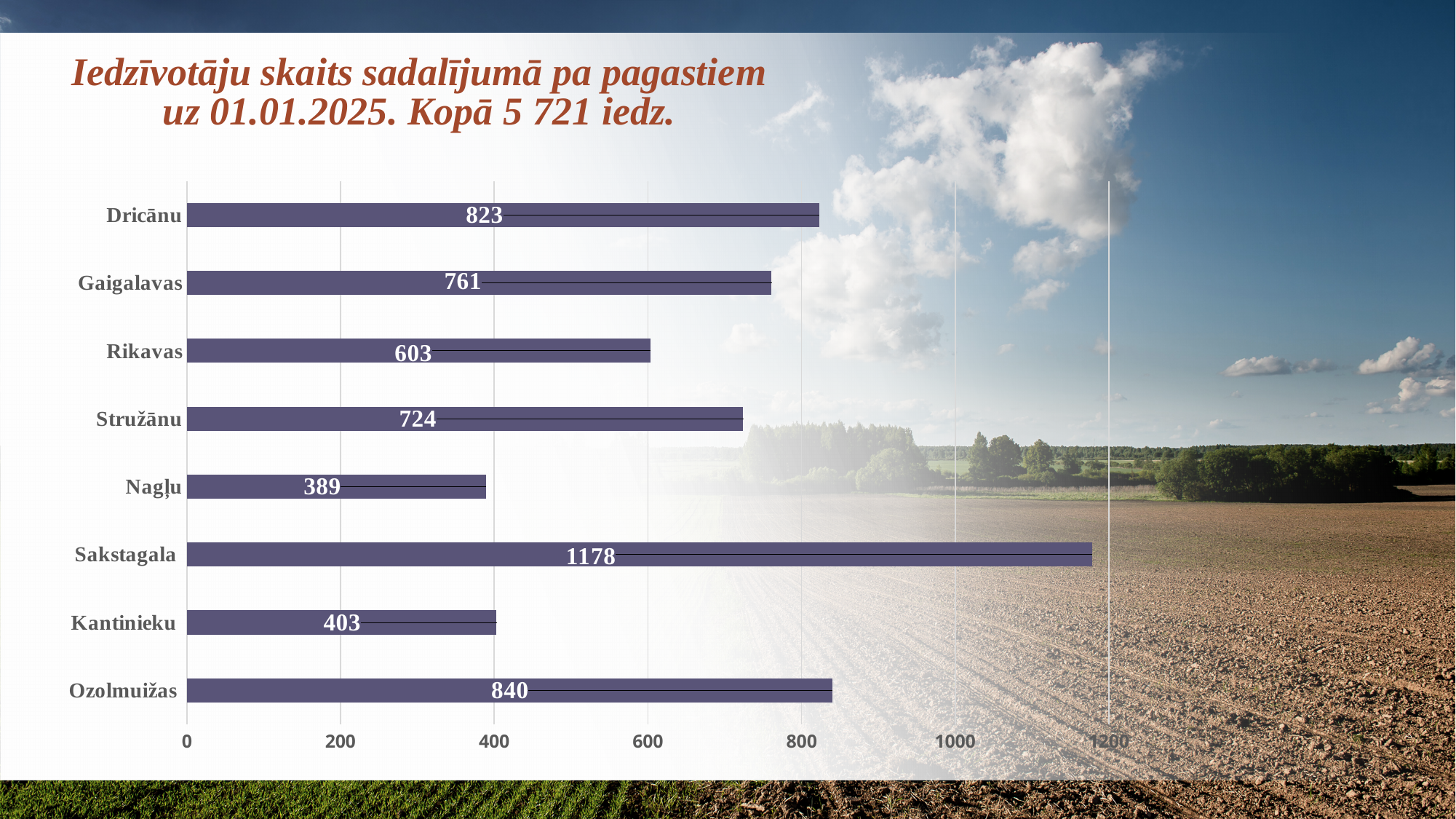
What total population is stated in the chart title? 5 721 iedz. What is the population value shown for Sakstagala? 1178 What is the population value shown for Nagļu? 389 What kind of chart is shown on the slide? bar chart Which parish has the highest population on the chart? Sakstagala What is the difference between the populations of Dricānu and Gaigalavas? 62 What is the population value shown for Ozolmuižas? 840 Which parish has the lowest population on the chart? Nagļu How many parishes are shown on the chart? 8 Which has a larger population, Stružānu or Rikavas? Stružānu Is the value for Kantinieku greater or less than 600? less What is the difference between the populations of Sakstagala and Nagļu? 789